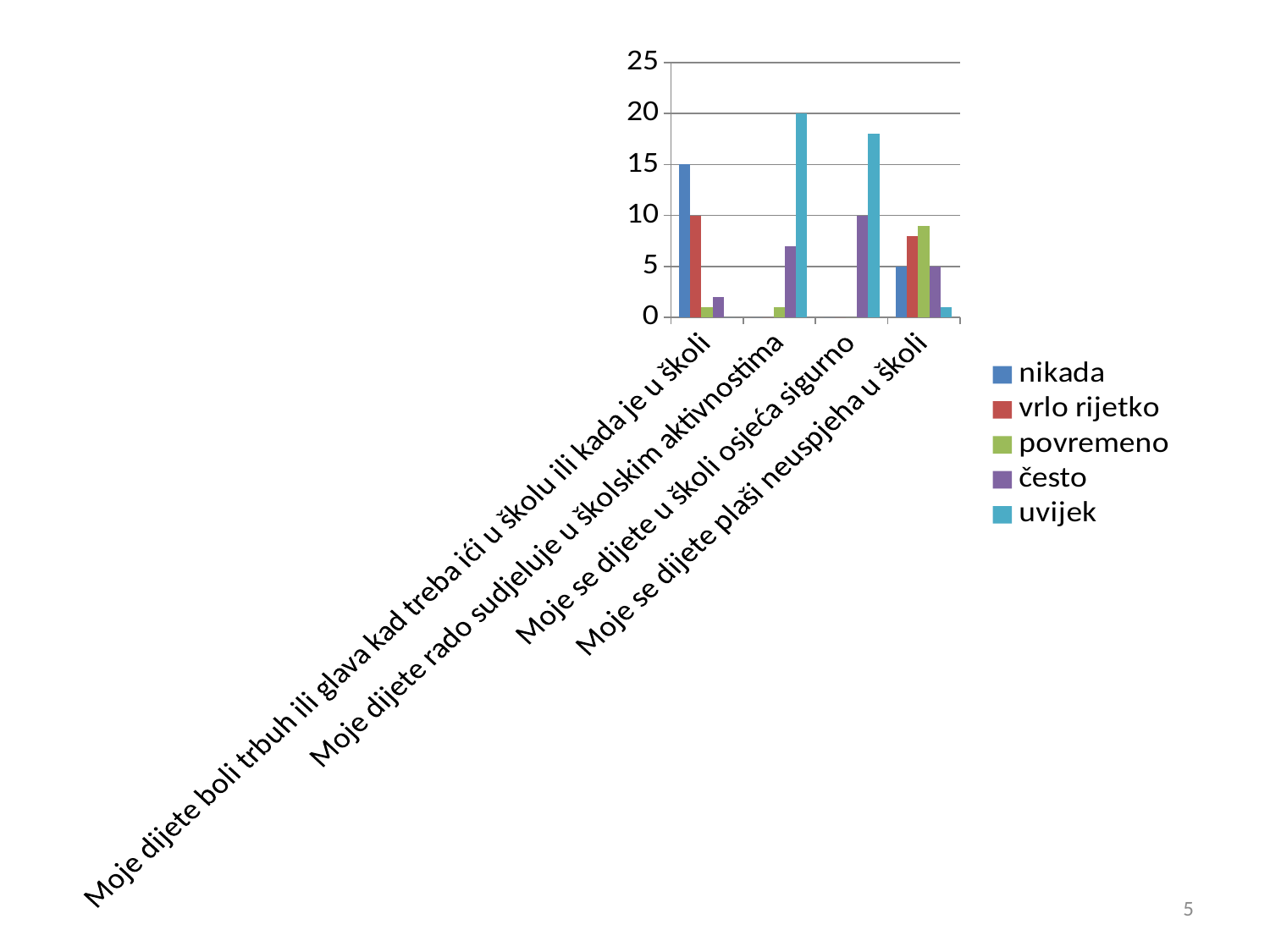
Which series has the highest value for "Moje dijete boli trbuh ili glava kad treba ići u školu ili kada je u školi"? nikada Which series has the highest value for "Moje se dijete u školi osjeća sigurno"? uvijek What is the value of "nikada" for "Moje dijete boli trbuh ili glava kad treba ići u školu ili kada je u školi"? 15 What is the value of "često" for "Moje se dijete u školi osjeća sigurno"? 10 What is the value of "uvijek" for "Moje dijete rado sudjeluje u školskim aktivnostima"? 20 Is the value of "uvijek" for "Moje se dijete u školi osjeća sigurno" greater or less than 15? greater How many series does the legend list? 5 What kind of chart is shown on the slide? bar chart What is the value of "vrlo rijetko" for "Moje dijete boli trbuh ili glava kad treba ići u školu ili kada je u školi"? 10 How many categories are shown on the x axis of the chart? 4 Is the value of "često" for "Moje dijete rado sudjeluje u školskim aktivnostima" greater or less than 10? less Which is larger for "Moje se dijete plaši neuspjeha u školi": the value of "povremeno" or the value of "uvijek"? povremeno